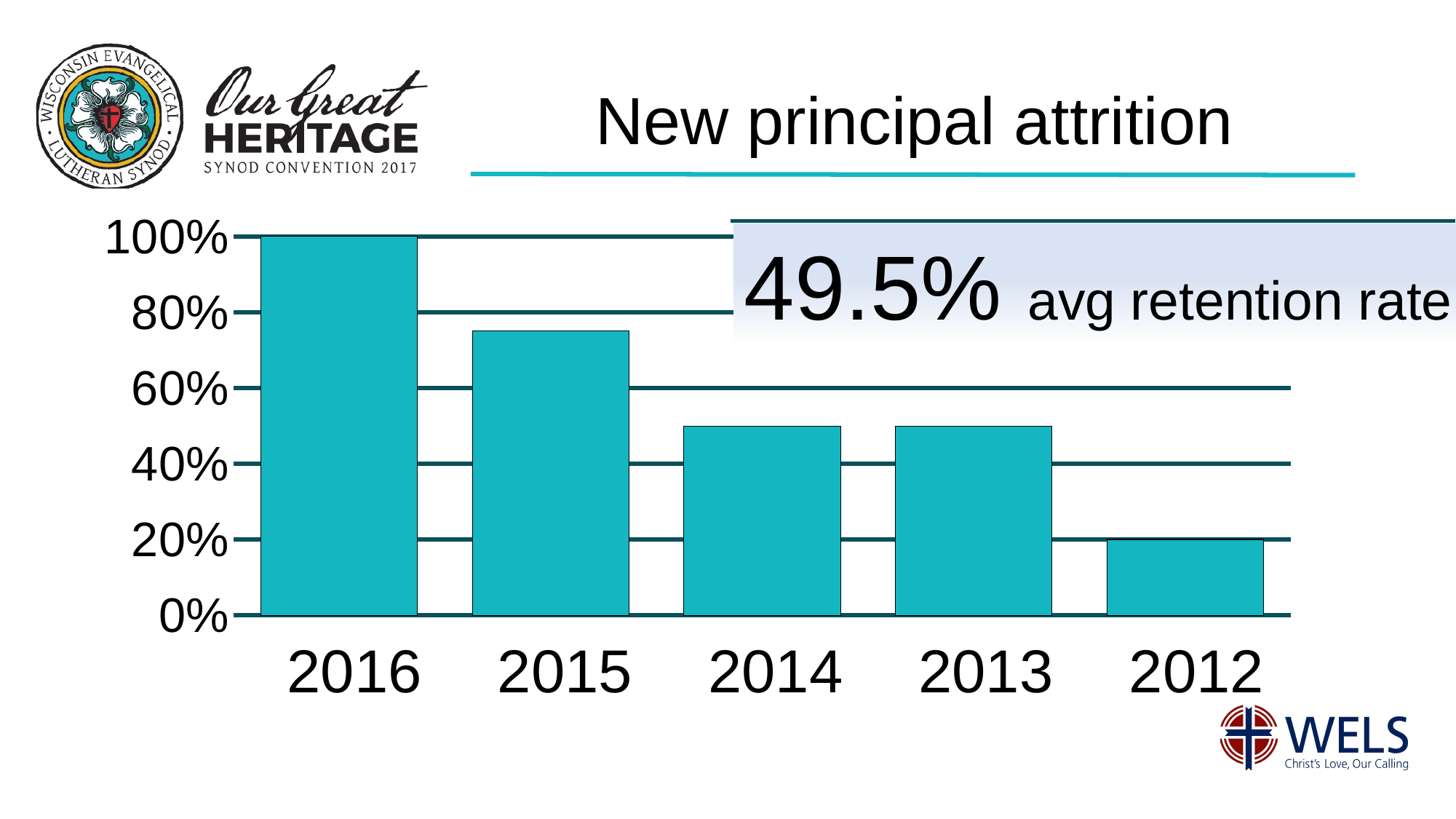
Which year has the highest bar? 2016 Is the value for 2015 greater or less than 60%? greater What is the difference between the values for 2016 and 2012? 80% What kind of chart is shown on the slide? Bar chart How many years are shown on the x axis? 5 Is the value for 2014 greater or less than 60%? less What is the value for 2012? 20% Is the value for 2013 greater or less than 40%? greater Which is larger, the value for 2015 or the value for 2014? 2015 Do the values rise or fall moving from left to right along the x axis? Fall What is the value for 2016? 100% Which year has the lowest bar? 2012